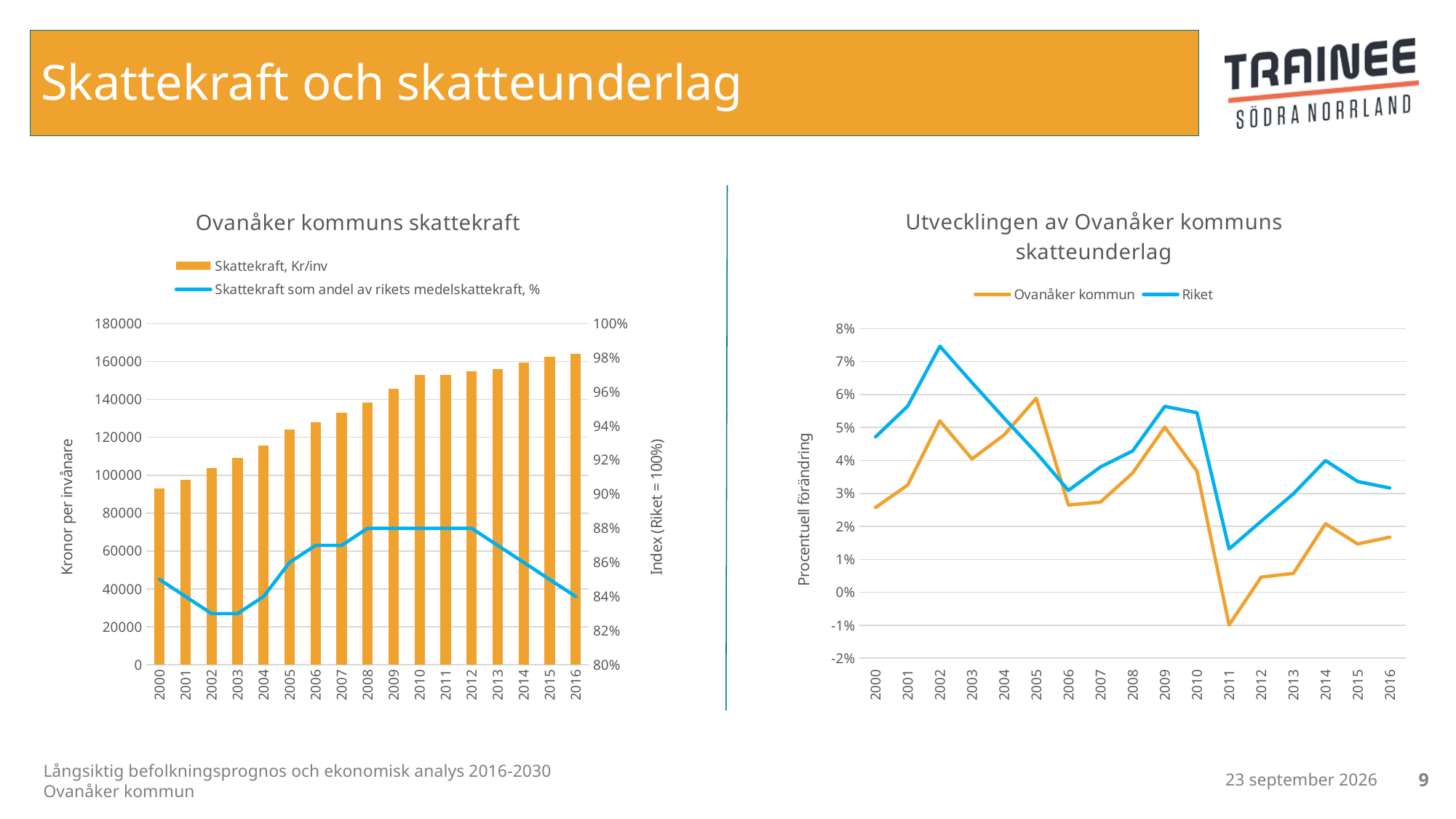
In the left chart 'Ovanåker kommuns skattekraft', is the Skattekraft, Kr/inv value for 2000 greater or less than 100000? less In the left chart 'Ovanåker kommuns skattekraft', how many series does the legend list? 2 In the left chart 'Ovanåker kommuns skattekraft', which year has the lowest bar for Skattekraft, Kr/inv? 2000 In the right chart 'Utvecklingen av Ovanåker kommuns skatteunderlag', how many years are shown on the x axis? 17 What type of chart is the right chart, 'Utvecklingen av Ovanåker kommuns skatteunderlag'? Line chart In the right chart 'Utvecklingen av Ovanåker kommuns skatteunderlag', which series has the larger value in 2002, Ovanåker kommun or Riket? Riket In the left chart 'Ovanåker kommuns skattekraft', which year has the highest bar for Skattekraft, Kr/inv? 2016 In the left chart 'Ovanåker kommuns skattekraft', is the Skattekraft, Kr/inv value for 2016 greater or less than 160000? greater What type of chart is the left chart, 'Ovanåker kommuns skattekraft'? Combined bar and line chart In the left chart 'Ovanåker kommuns skattekraft', do the Skattekraft, Kr/inv bars rise or fall from 2000 to 2016? Rise In the right chart 'Utvecklingen av Ovanåker kommuns skatteunderlag', which year has the lowest value for Ovanåker kommun? 2011 In the right chart 'Utvecklingen av Ovanåker kommuns skatteunderlag', which year has the highest value for Riket? 2002